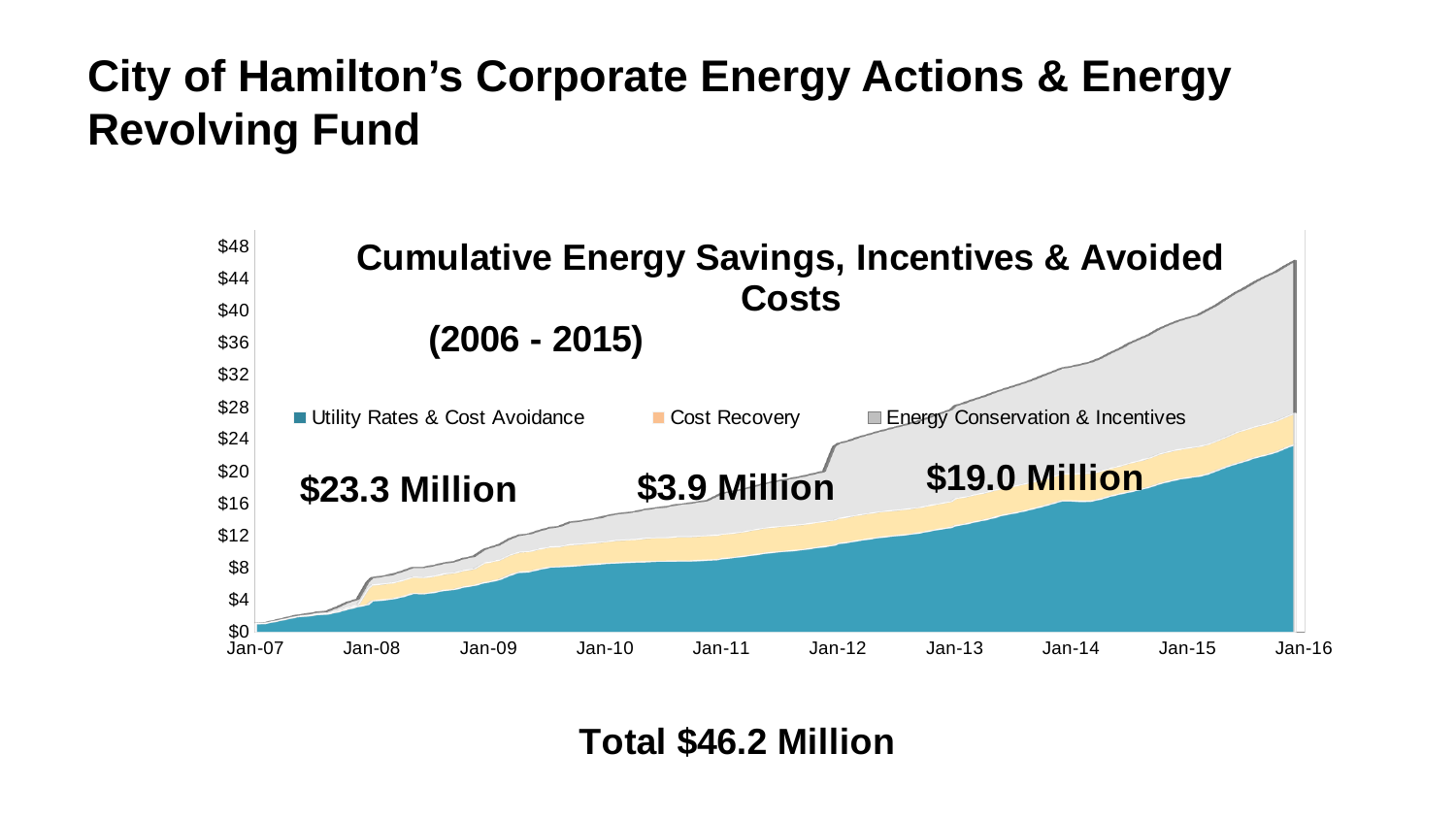
What is the cumulative value labelled for Cost Recovery? $3.9 Million What is the difference between the labelled values for Utility Rates & Cost Avoidance and Energy Conservation & Incentives? $4.3 Million Which series has the largest labelled cumulative value? Utility Rates & Cost Avoidance How many series does the chart's legend list? 3 What kind of chart is shown on the slide? Area chart What is the time period given in the chart title? 2006 - 2015 Is the total cumulative value at Jan-16 greater or less than $40? greater What is the cumulative value labelled for Energy Conservation & Incentives? $19.0 Million Do the cumulative values rise or fall from Jan-07 to Jan-16? Rise What is the cumulative value labelled for Utility Rates & Cost Avoidance? $23.3 Million Which series has the smallest labelled cumulative value? Cost Recovery What is the total cumulative value stated on the slide? $46.2 Million